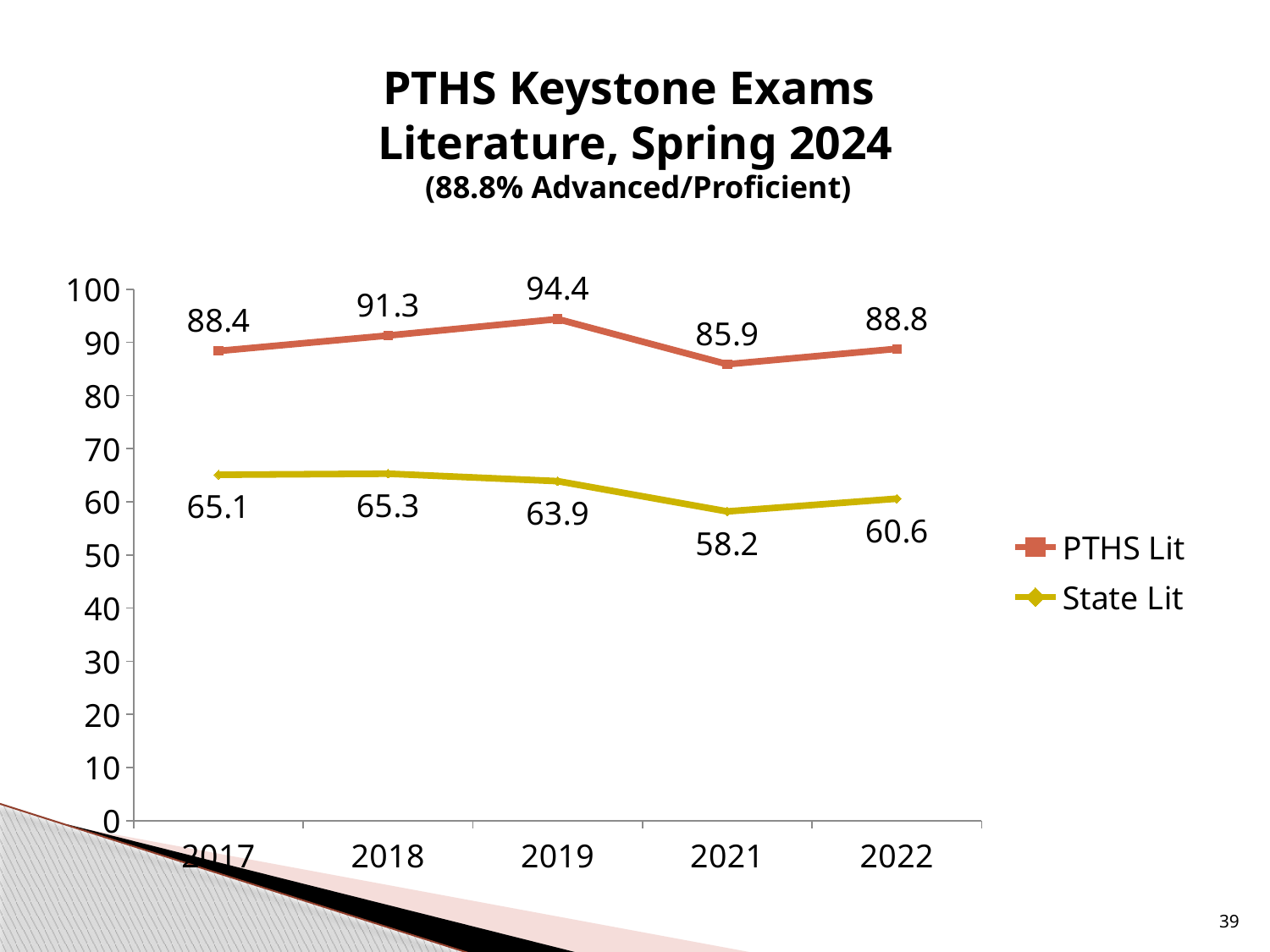
What is the difference between the PTHS Lit and State Lit values in 2017? 23.3 How many years are shown on the x axis? 5 Does the State Lit value rise or fall from 2019 to 2021? fall What is the PTHS Lit value for 2022? 88.8 What kind of chart is shown on the slide? line chart Is the State Lit value for 2018 greater or less than 60? greater In which year is the PTHS Lit value highest? 2019 What is the State Lit value for 2021? 58.2 Which is larger in 2022: the PTHS Lit value or the State Lit value? PTHS Lit In which year is the State Lit value lowest? 2021 What is the PTHS Lit value for 2019? 94.4 How many series does the legend list? 2